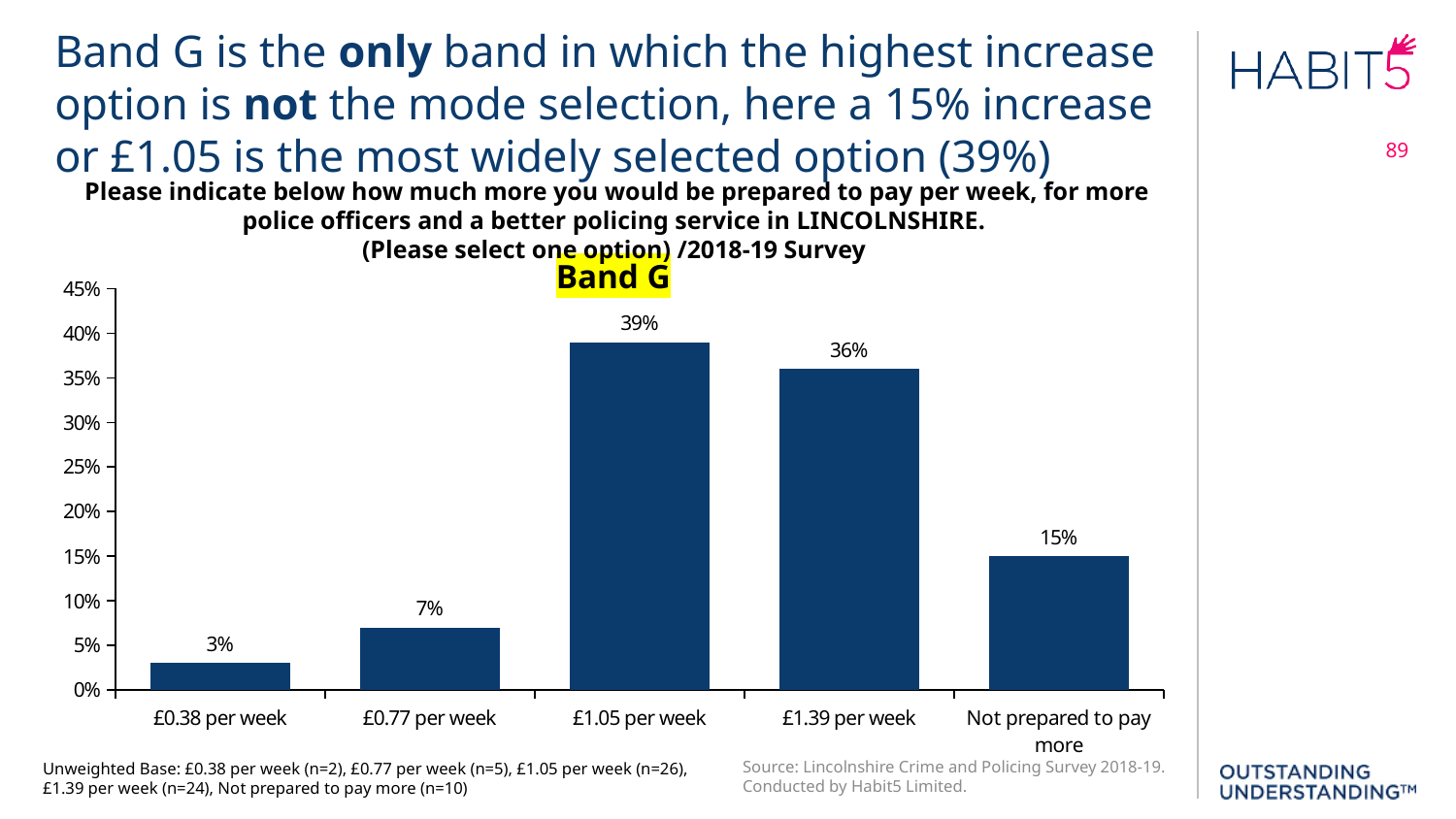
Which option has the highest percentage? £1.05 per week What percentage selected £0.77 per week? 7% Which is larger: the value for £0.77 per week or the value for £0.38 per week? £0.77 per week What is the value for 'Not prepared to pay more'? 15% What percentage of Band G respondents selected £1.05 per week? 39% What is the difference between the £1.39 per week value and the 'Not prepared to pay more' value? 21% What type of chart is shown on the slide? Bar chart Is the value for £1.39 per week greater or less than 30%? greater What is the highlighted label above the chart indicating which band the data is for? Band G How many options (bars) are shown in the chart? 5 Which option has the lowest percentage? £0.38 per week What is the difference between the £1.05 per week and £1.39 per week values? 3%